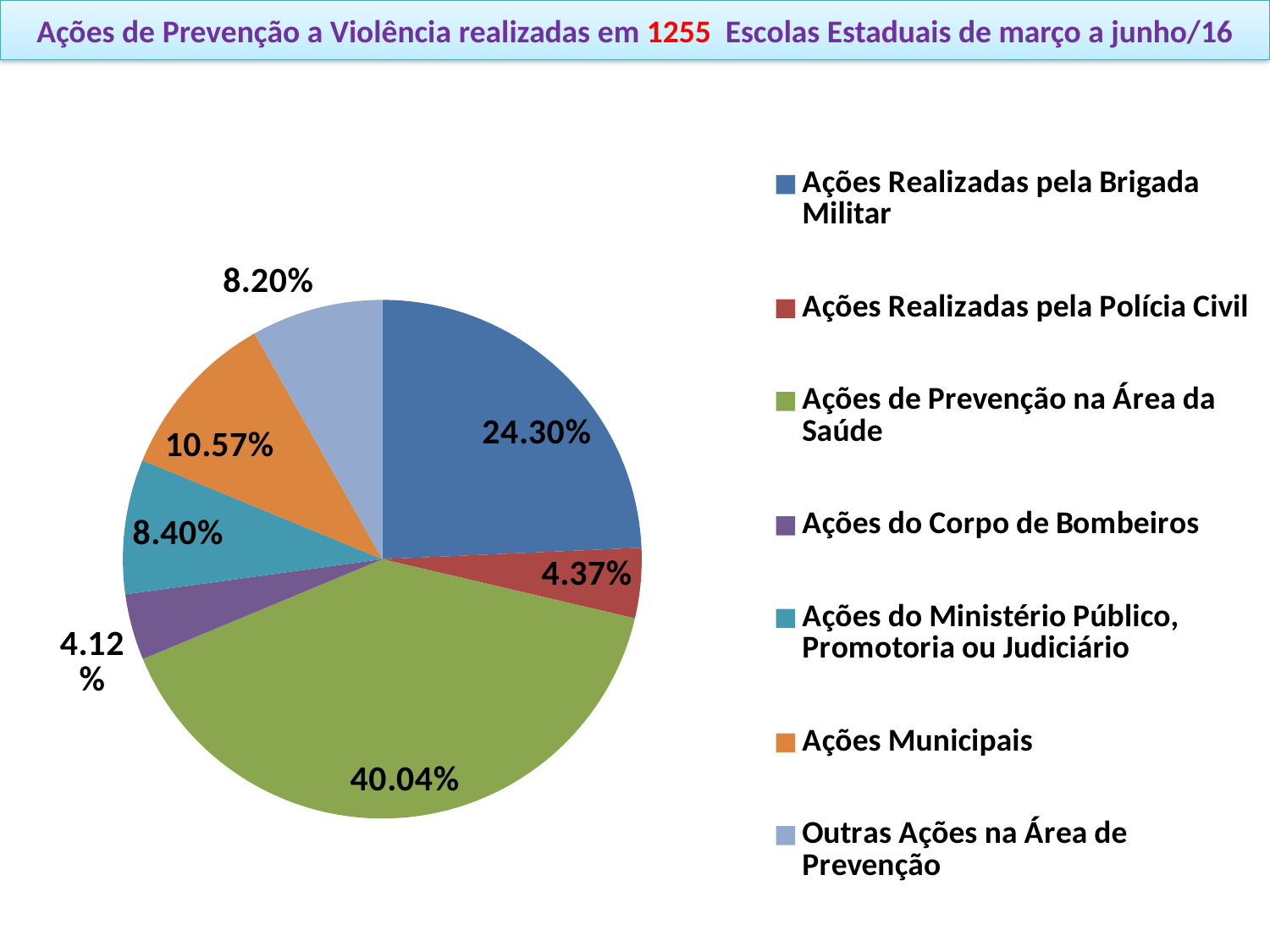
What share of the pie is labelled for Outras Ações na Área de Prevenção? 8.20% Which category has the largest slice of the pie? Ações de Prevenção na Área da Saúde How many categories does the legend list? 7 What share of the pie is labelled for Ações Municipais? 10.57% Which is larger: the slice for Ações Municipais or the slice for Ações do Ministério Público, Promotoria ou Judiciário? Ações Municipais What share of the pie is labelled for Ações de Prevenção na Área da Saúde? 40.04% What share of the pie is labelled for Ações Realizadas pela Brigada Militar? 24.30% What is the difference in percentage points between Ações de Prevenção na Área da Saúde and Ações Realizadas pela Brigada Militar? 15.74 What kind of chart is shown on the slide? pie chart Which category has the smallest slice of the pie? Ações do Corpo de Bombeiros What share of the pie is labelled for Ações do Corpo de Bombeiros? 4.12% How many schools does the slide title say the actions were carried out in? 1255